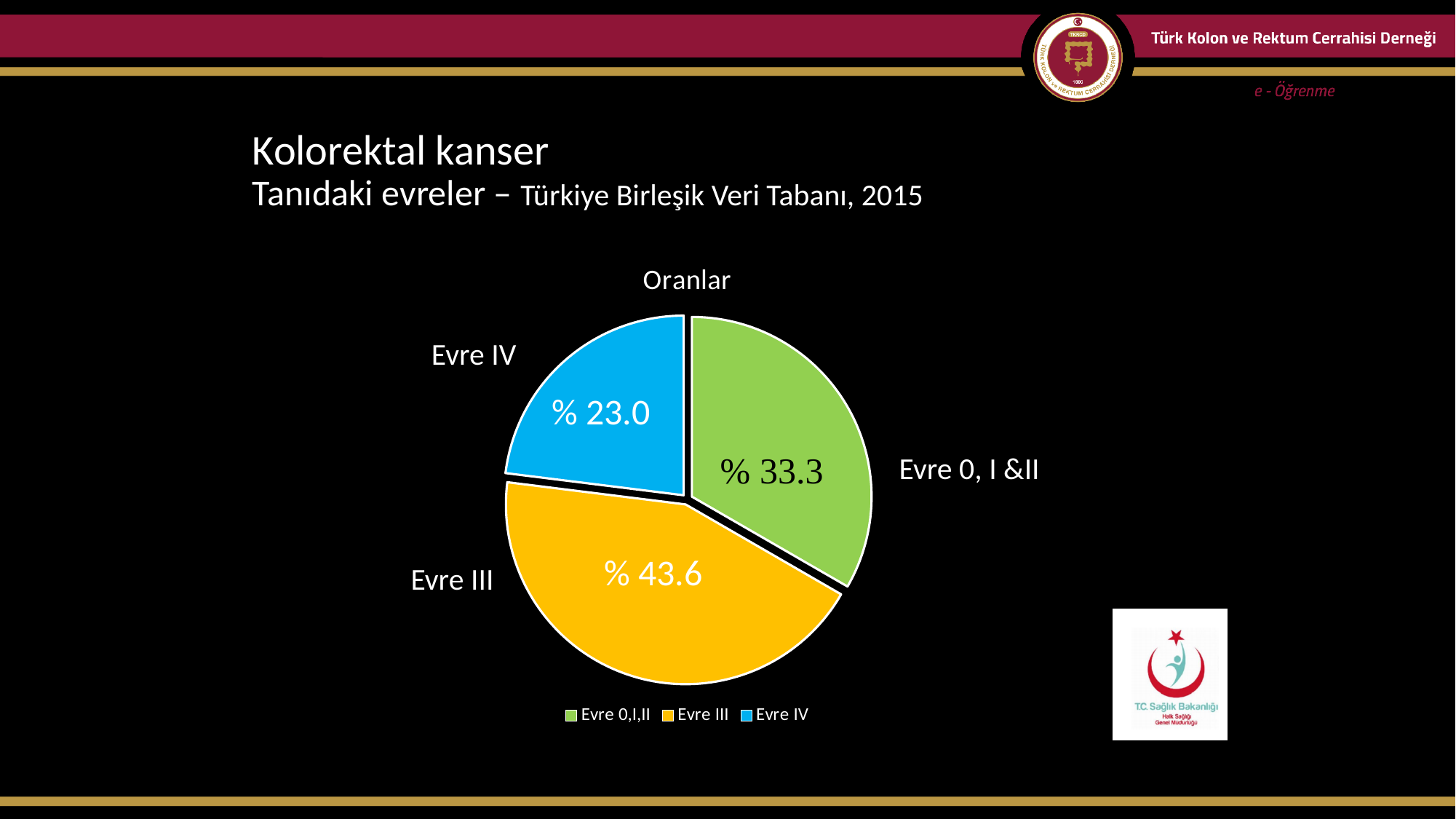
What is the value for Evre III? % 43.6 Which stage has the smallest share of the pie? Evre IV What is the value for Evre IV? % 23.0 What is the chart's title? Oranlar What type of chart is shown on the slide? pie chart What is the difference between the values for Evre III and Evre IV? % 20.6 What is the difference between the values for Evre III and Evre 0, I & II? % 10.3 What is the value for Evre 0, I & II? % 33.3 What colour is the Evre IV slice? blue Which stage has the largest share of the pie? Evre III Which is larger, the value for Evre 0, I & II or the value for Evre IV? Evre 0, I & II How many slices does the pie chart have? 3